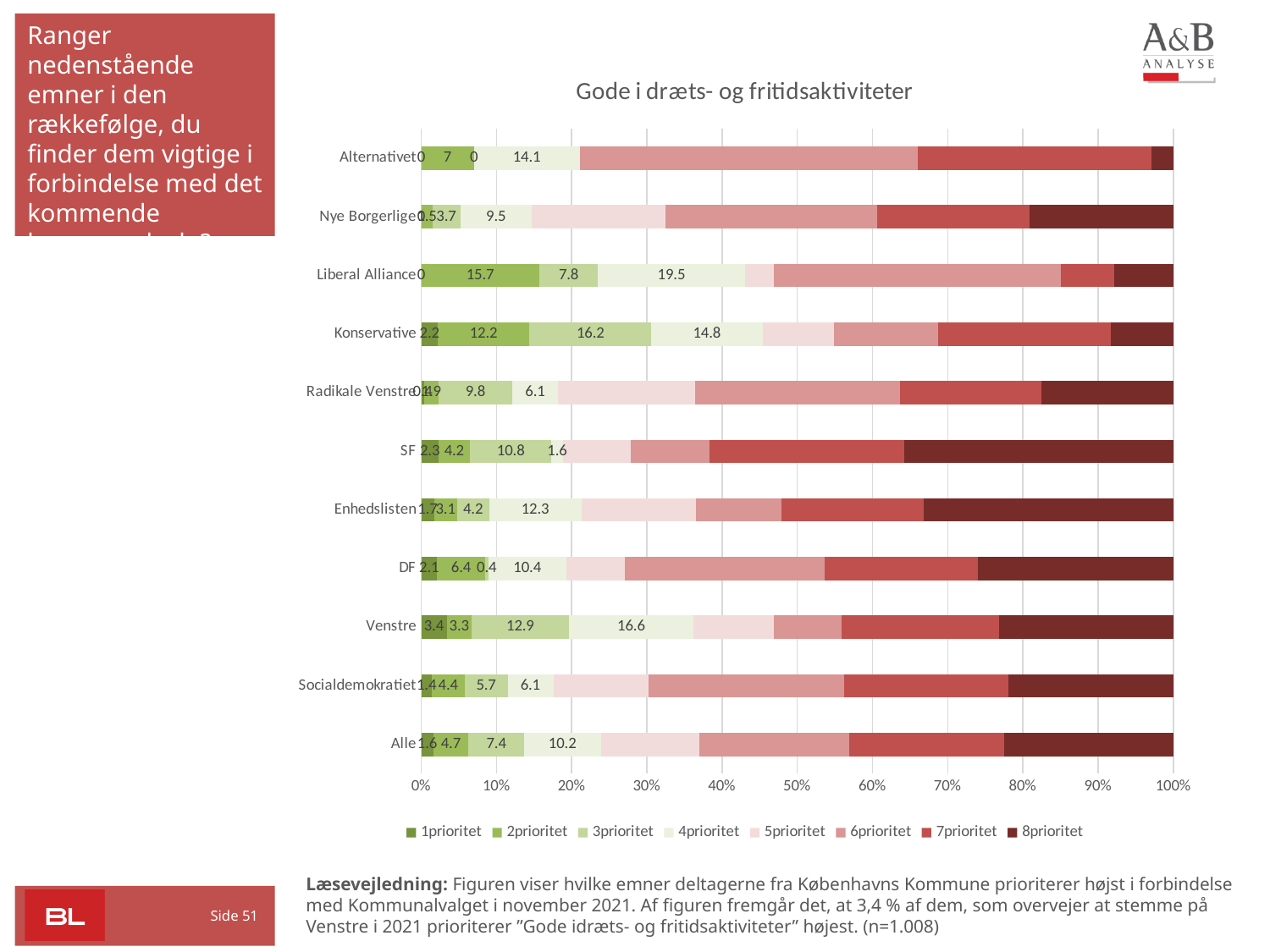
What is the value for 4prioritet for Alternativet? 14.1 What is the difference between the 2prioritet values for Liberal Alliance and Konservative? 3.5 What is the value for 1prioritet for Venstre? 3.4 Which is larger, the 3prioritet value for Konservative or for Venstre? Konservative Which category has the highest value for 4prioritet? Liberal Alliance How many series does the legend list? 8 What kind of chart is shown on the slide? Stacked bar chart Which category has the highest value for 2prioritet? Liberal Alliance What is the value for 2prioritet for Liberal Alliance? 15.7 What is the value for 4prioritet for Alle? 10.2 How many categories (parties) are shown on the chart? 11 What is the value for 3prioritet for Konservative? 16.2